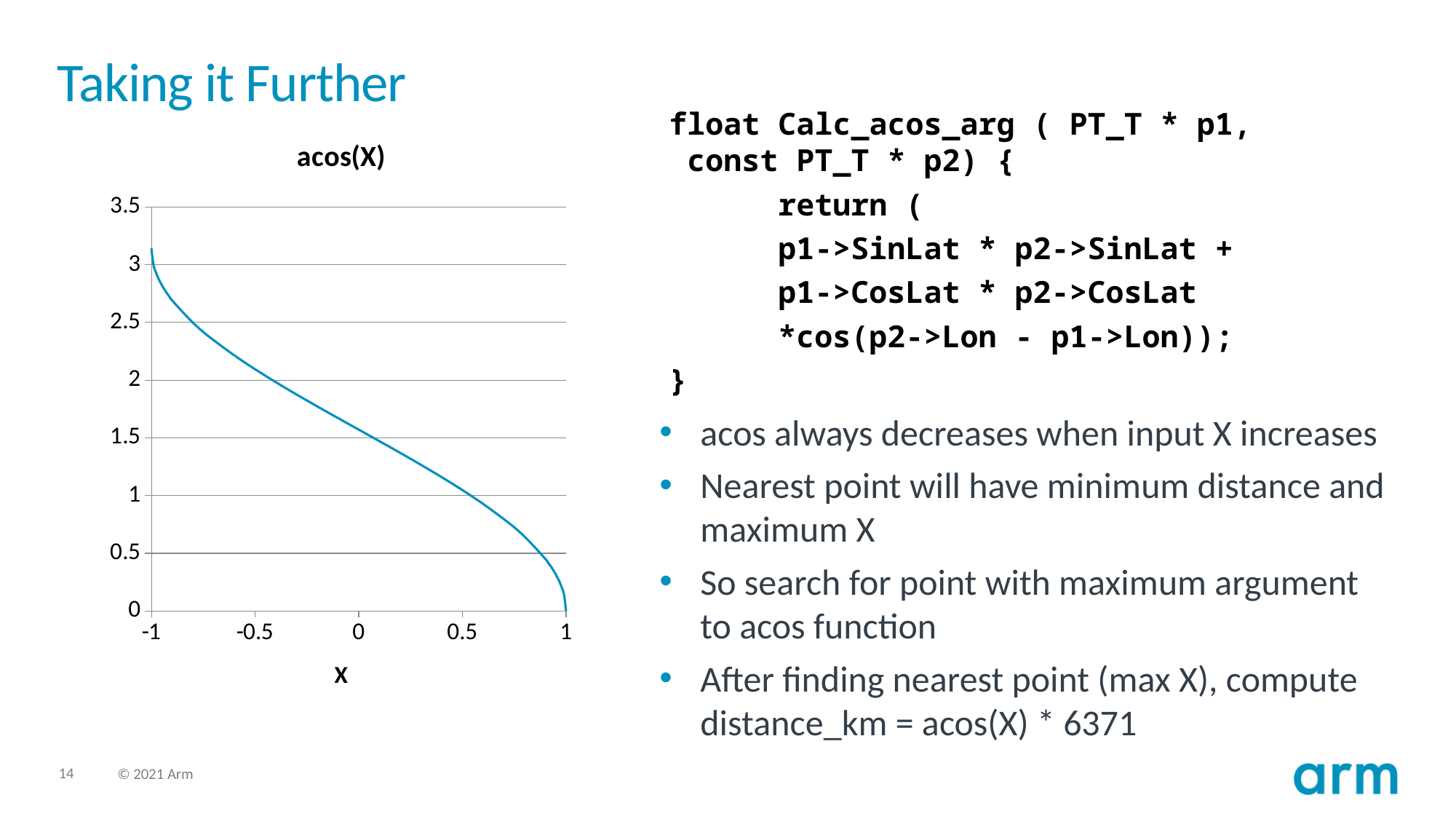
At which value of X does the curve reach its lowest point? 1 Which is larger, the value of acos(X) at X = -0.5 or at X = 0.5? X = -0.5 Is the value of acos(X) at X = 0.5 greater or less than 1.5? less What is the label on the x axis of the chart? X What is the title of the chart? acos(X) Is the value of acos(X) at X = 1 greater or less than 0.5? less Is the value of acos(X) at X = -1 greater or less than 3? greater What kind of chart is shown on the slide? line chart At which value of X does the curve reach its highest point? -1 Does the plotted value rise or fall as X increases from -1 to 1? fall